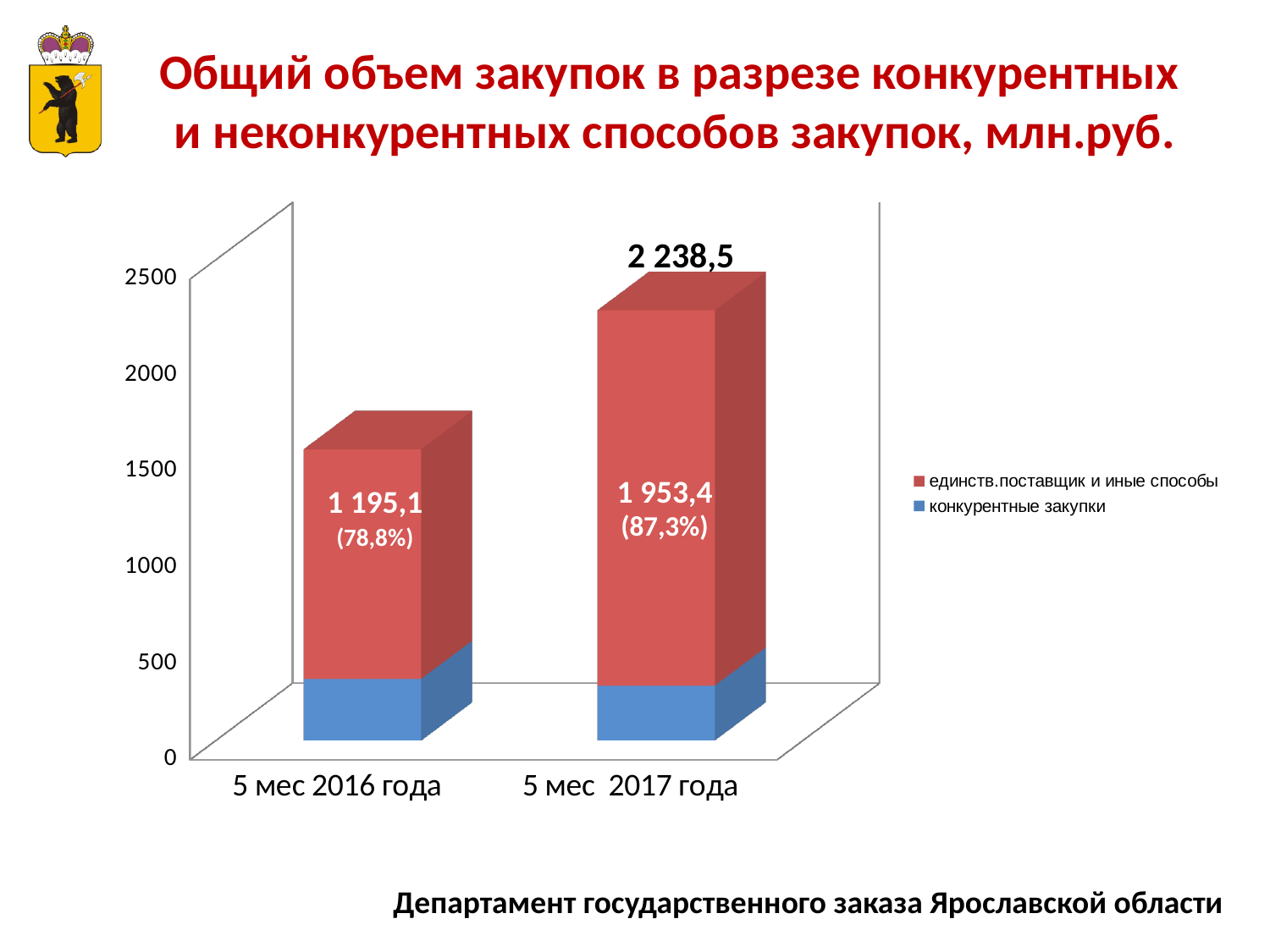
What kind of chart is shown on the slide? stacked bar chart What is the total of the stacked bar for 5 мес 2017 года? 2 238,5 What is the value for единств.поставщик и иные способы in 5 мес 2016 года? 1 195,1 How many categories are shown on the x axis? 2 How many series does the legend list? 2 What is the value for единств.поставщик и иные способы in 5 мес 2017 года? 1 953,4 Which period has the larger value for единств.поставщик и иные способы, 5 мес 2016 года or 5 мес 2017 года? 5 мес 2017 года Is the value for конкурентные закупки in 5 мес 2016 года greater or less than 500? less What percentage is shown in parentheses for единств.поставщик и иные способы in 5 мес 2017 года? 87,3% What percentage is shown in parentheses for единств.поставщик и иные способы in 5 мес 2016 года? 78,8% By how much did the value for единств.поставщик и иные способы increase from 5 мес 2016 года to 5 мес 2017 года? 758,3 Which colour represents конкурентные закупки in the chart? blue